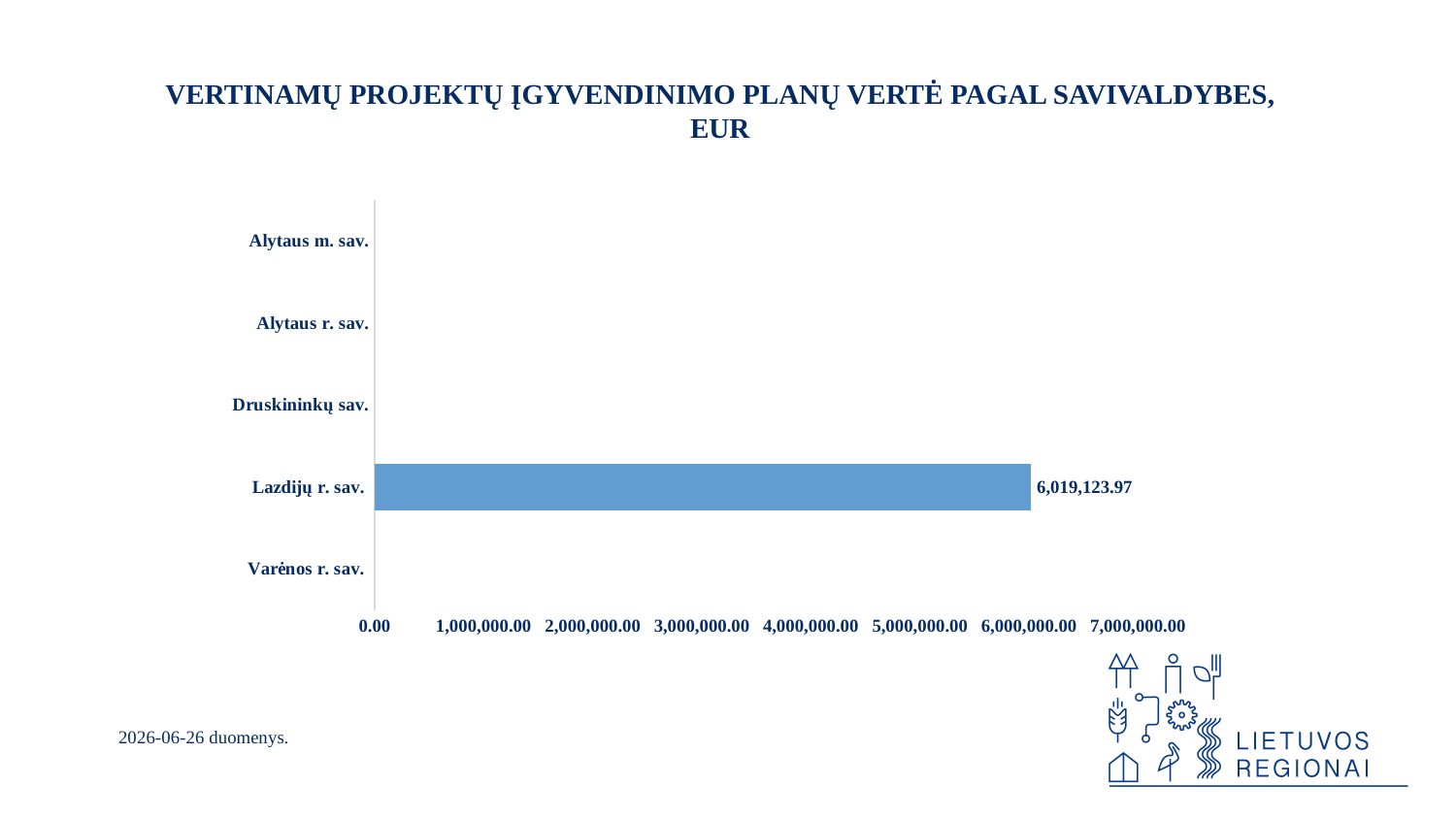
Which municipality is listed first (at the top) on the vertical axis? Alytaus m. sav. What is the value for Lazdijų r. sav.? 6,019,123.97 Is the value for Lazdijų r. sav. greater or less than 7,000,000.00? less What is the title of the chart? VERTINAMŲ PROJEKTŲ ĮGYVENDINIMO PLANŲ VERTĖ PAGAL SAVIVALDYBES, EUR What is the highest tick value shown on the horizontal axis? 7,000,000.00 What kind of chart is shown on the slide? Bar chart How many municipalities have a visible bar in the chart? 1 Which is larger, the value for Lazdijų r. sav. or the value for Varėnos r. sav.? Lazdijų r. sav. Is the value for Lazdijų r. sav. greater or less than 5,000,000.00? greater How many municipalities are listed on the vertical axis? 5 Which municipality has the highest value? Lazdijų r. sav.